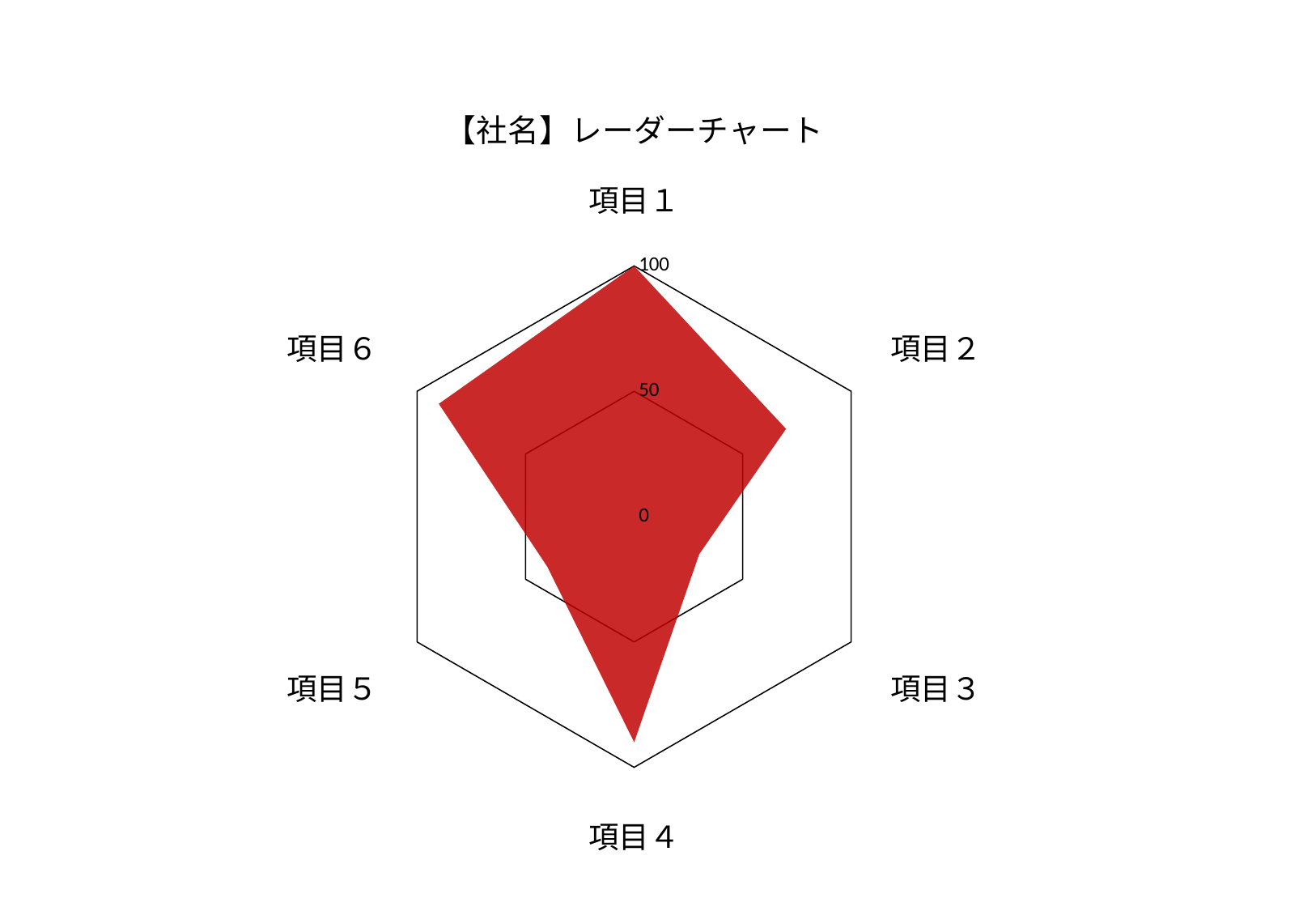
What is the value for 項目1? 100 Which is larger, the value for 項目2 or the value for 項目3? 項目2 What is the title of the chart? 【社名】レーダーチャート What is the maximum value shown on the radar chart's axis scale? 100 Is the value for 項目3 greater or less than 50? less Which category has the highest value? 項目1 Is the value for 項目4 greater or less than 50? greater Is the value for 項目6 greater or less than 50? greater What kind of chart is shown on the slide? Radar chart How many categories (axes) does the radar chart have? 6 Which is larger, the value for 項目1 or the value for 項目3? 項目1